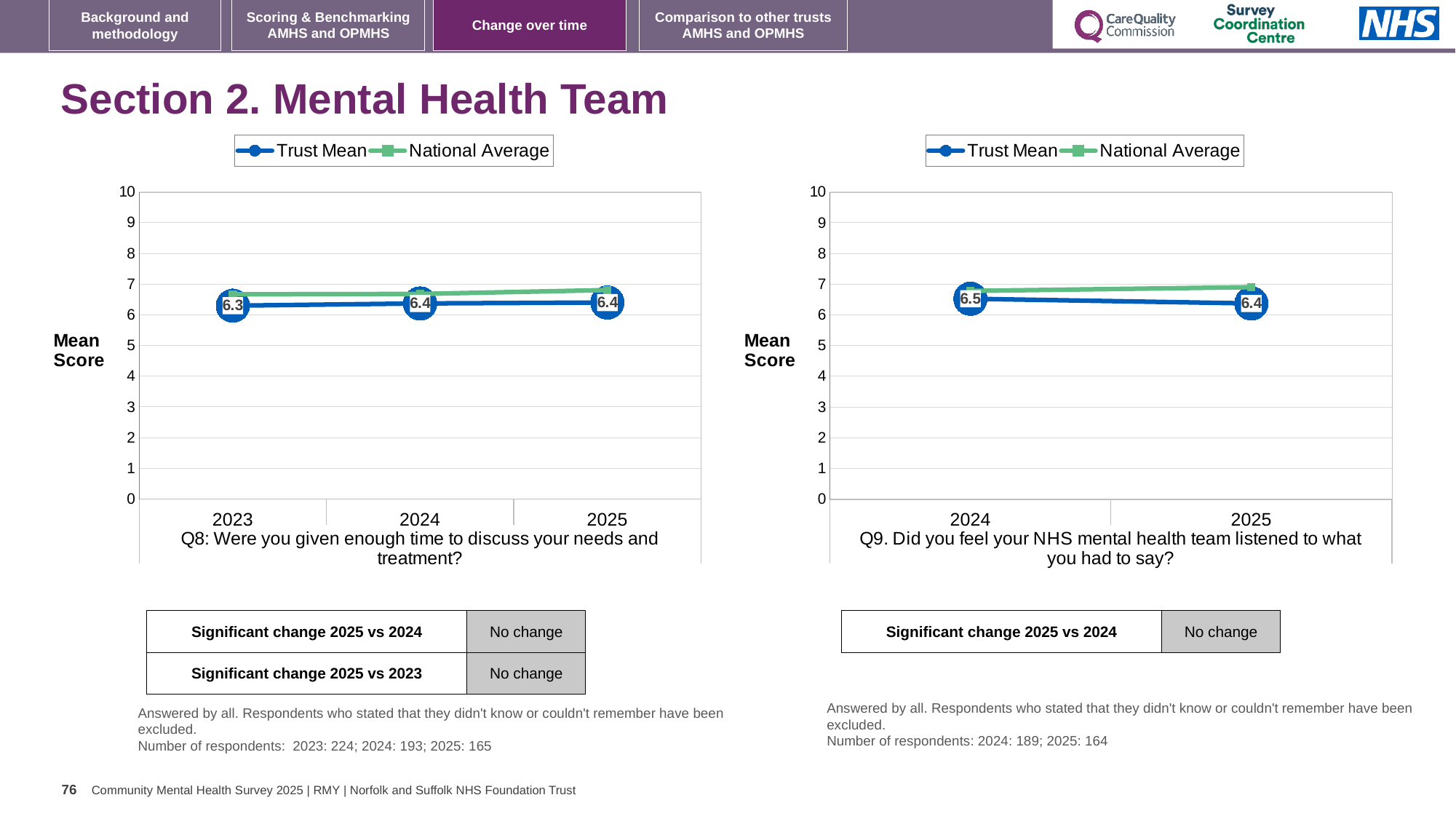
What kind of chart is used for Q8 on the left? Line chart In the Q8 chart on the left, which year has the lowest Trust Mean? 2023 How many years are plotted on the x axis of the Q8 chart on the left? 3 In the Q9 chart on the right, is the Trust Mean or the National Average higher in 2025? National Average In the Q8 chart on the left, what is the Trust Mean for 2023? 6.3 In the Q8 chart on the left, what is the difference between the Trust Mean for 2024 and 2023? 0.1 In the Q9 chart on the right, which year has the higher Trust Mean? 2024 In the Q9 chart on the right, what is the Trust Mean for 2024? 6.5 In the Q8 chart on the left, what is the Trust Mean for 2025? 6.4 How many series does the legend of the Q9 chart on the right list? 2 In the Q9 chart on the right, what is the Trust Mean for 2025? 6.4 In the Q8 chart on the left, is the National Average for 2025 greater or less than 5? greater